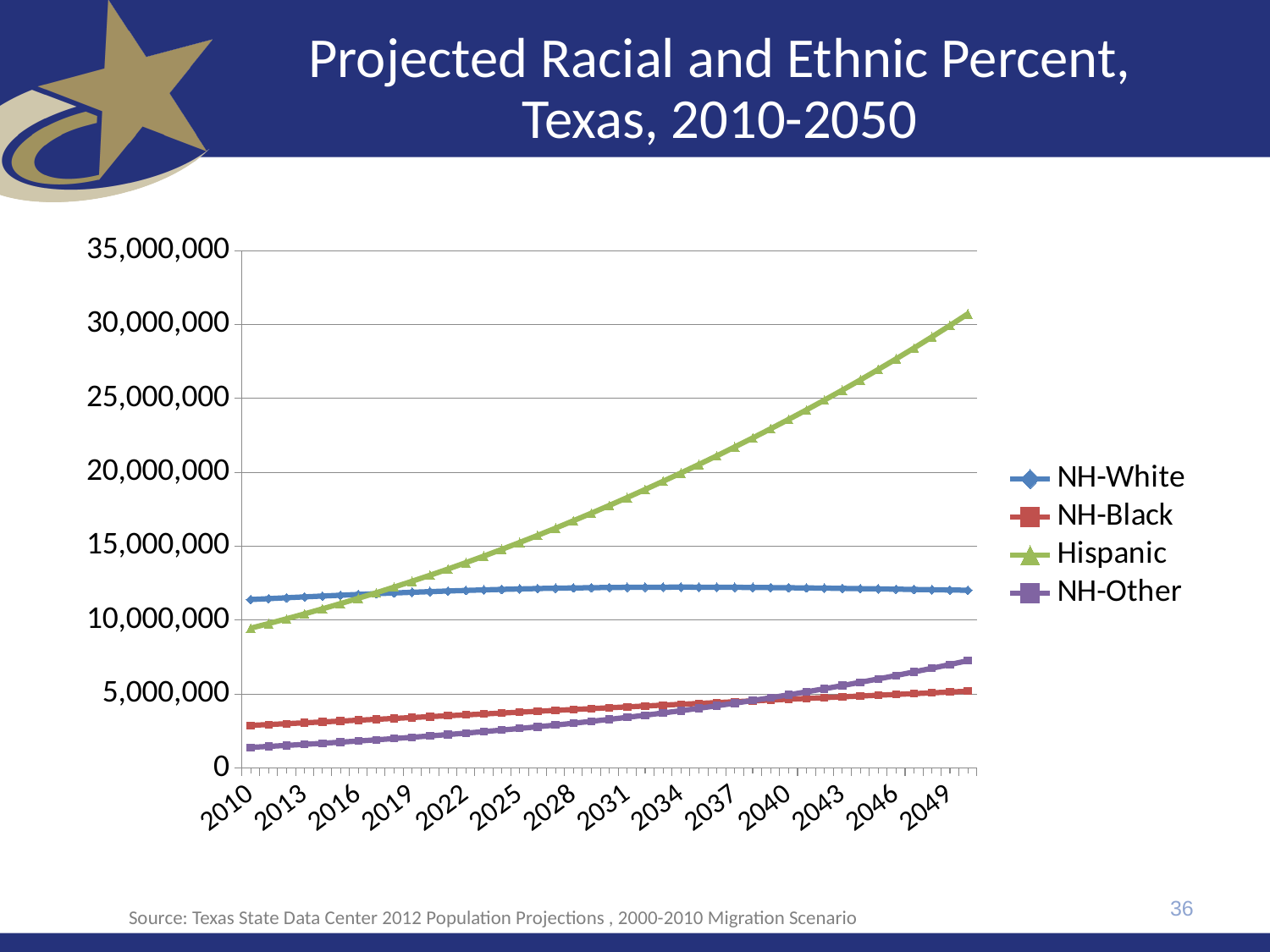
Which series has the highest value in 2049? Hispanic Does the Hispanic series rise or fall from 2010 to 2049? rise How many series does the legend list? 4 Is the value for Hispanic in 2040 greater or less than 20,000,000? greater Is the value for NH-Other in 2049 greater or less than 5,000,000? greater What is the title of the chart on the slide? Projected Racial and Ethnic Percent, Texas, 2010-2050 What kind of chart is shown on the slide? line chart Which is larger in 2010, NH-White or Hispanic? NH-White Which is larger in 2049, NH-Black or NH-Other? NH-Other Is the value for Hispanic in 2010 greater or less than 10,000,000? less Which series has the lowest value in 2010? NH-Other